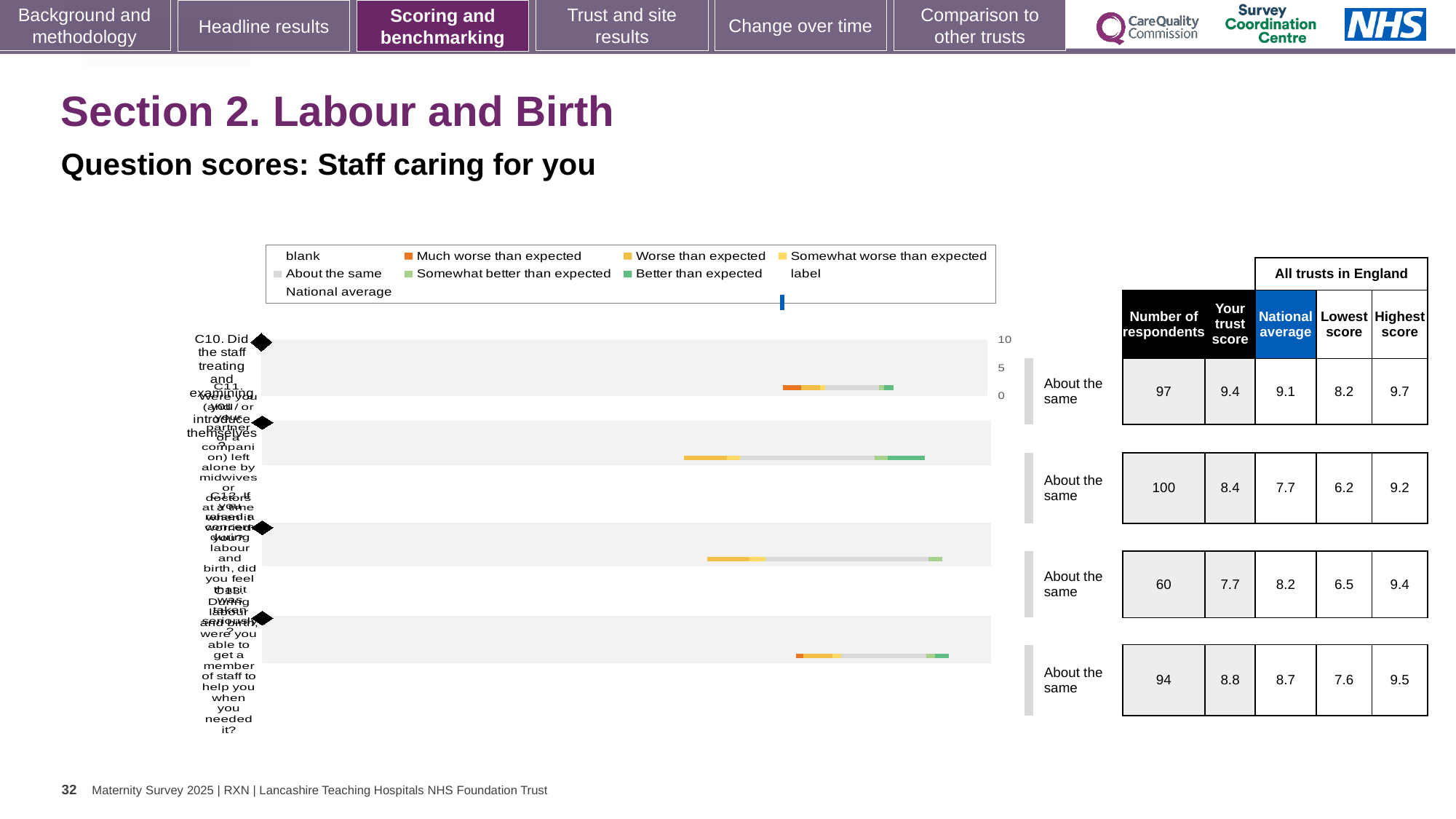
What kind of chart is shown on the slide? bar chart In the table beside the chart, is the trust score in the second row higher or lower than the national average? higher In the table beside the chart, which row has the lowest number of respondents? third row (60) In the chart legend, which entry is shown in orange? Much worse than expected In the table beside the chart, what is the trust score for the second row? 8.4 In the table beside the chart, which row has the highest trust score? first row (9.4) In the table beside the chart, what is the difference between the trust score and the national average in the first row? 0.3 In the table beside the chart, what is the national average for the third row? 8.2 In the table beside the chart, what is the highest score for the fourth row? 9.5 What comparison label is shown for every row of the chart? About the same In the table beside the chart, what is the number of respondents for the first row? 97 How many question rows (categories) are plotted in the chart? 4